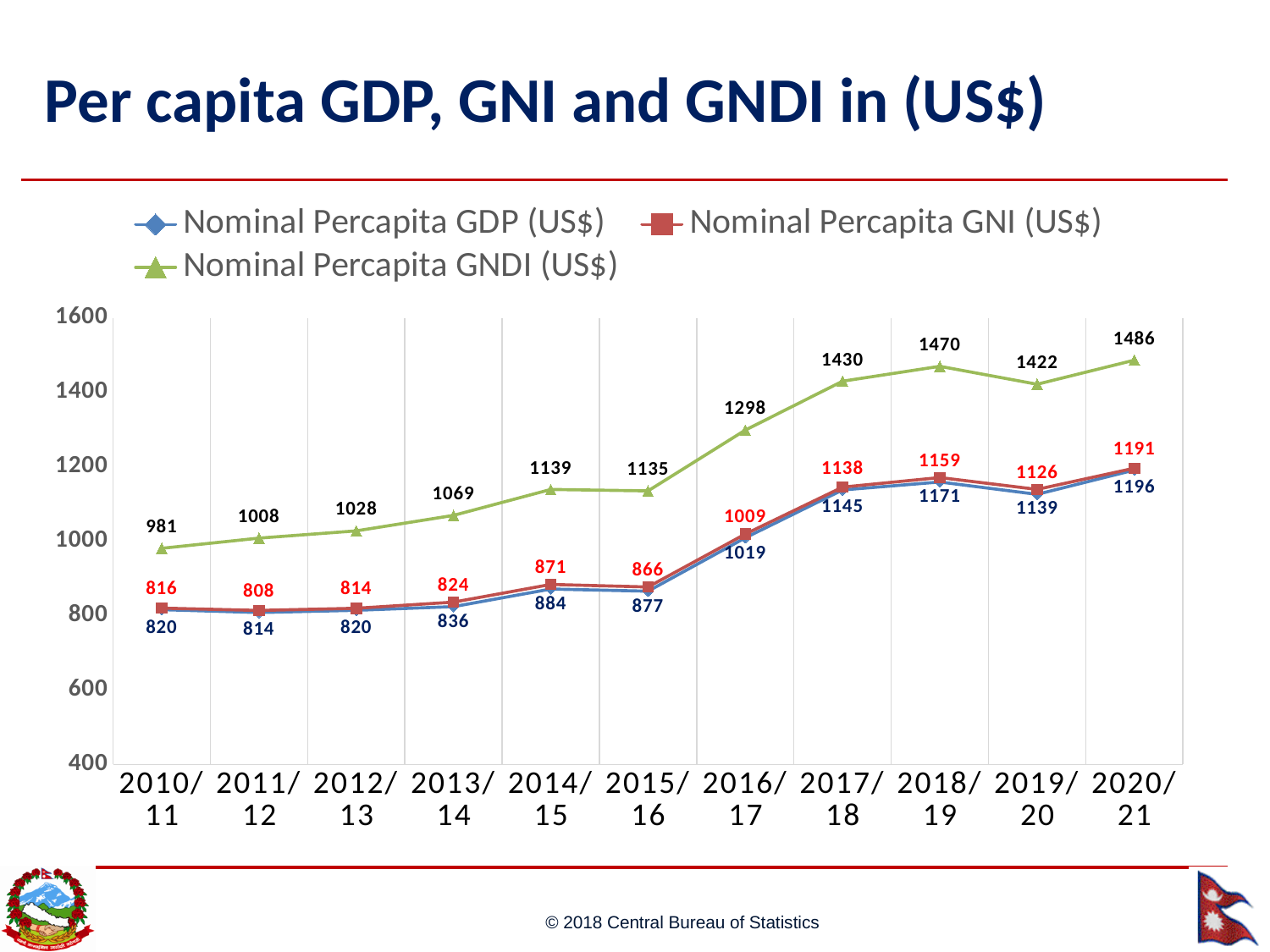
Is the Nominal Percapita GNDI (US$) value for 2017/18 greater or less than 1400? greater In which year is Nominal Percapita GNI (US$) lowest? 2011/12 How many fiscal years are plotted along the x axis? 11 What is the Nominal Percapita GDP (US$) value for 2014/15? 884 In which year is Nominal Percapita GNDI (US$) highest? 2020/21 What is the Nominal Percapita GNDI (US$) value for 2020/21? 1486 By how much did Nominal Percapita GNDI (US$) increase from 2019/20 to 2020/21? 64 What kind of chart is shown on the slide? line chart How many series does the legend list? 3 Which year has the higher Nominal Percapita GNDI (US$), 2018/19 or 2019/20? 2018/19 What is the Nominal Percapita GNI (US$) value for 2016/17? 1009 Overall, does Nominal Percapita GNDI (US$) rise or fall from 2010/11 to 2020/21? rise